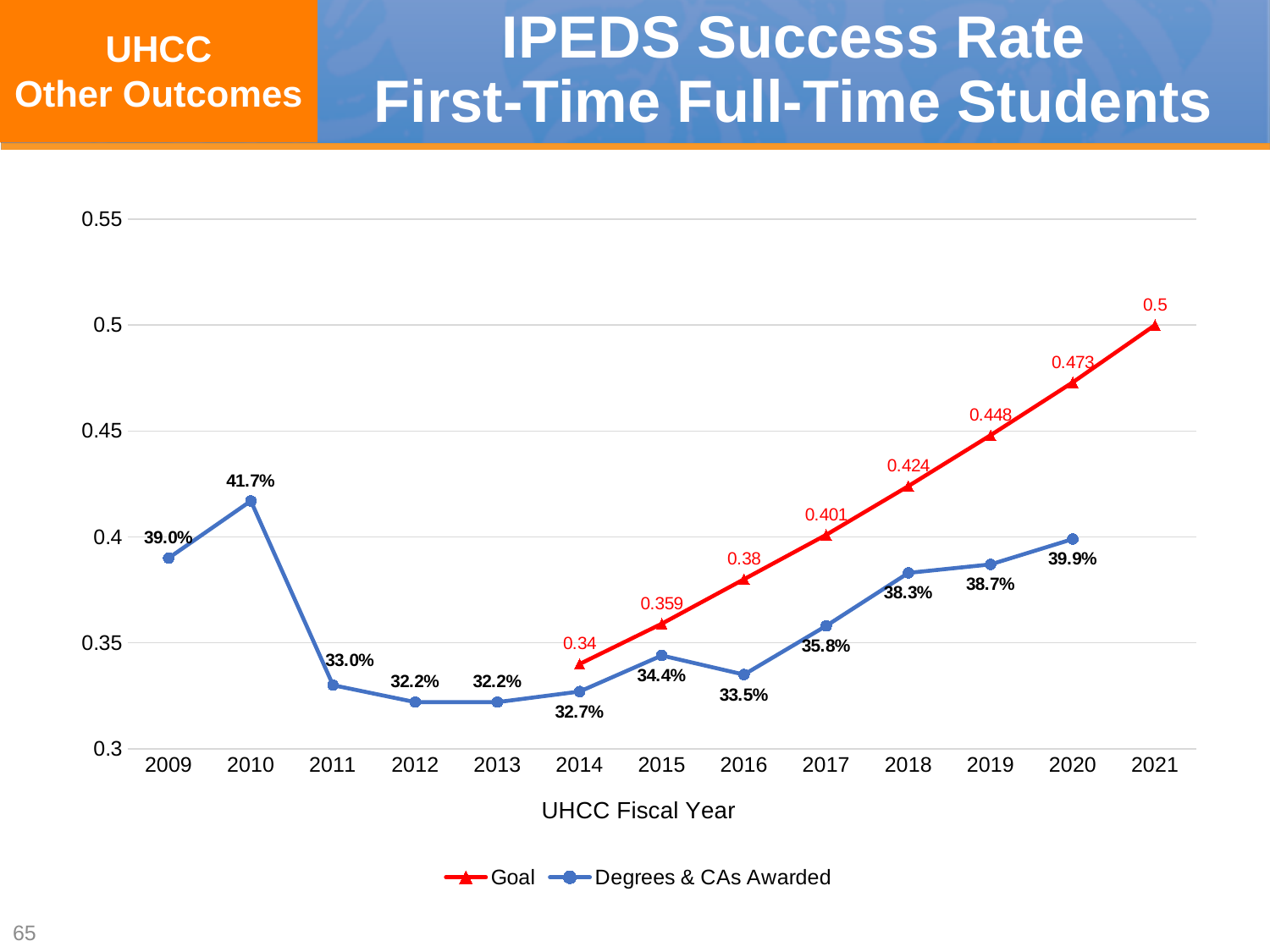
In which year is the Goal series lowest? 2014 What kind of chart is shown on the slide? line chart Is the Degrees & CAs Awarded value for 2016 greater or less than 0.35? less How many fiscal years are shown on the x axis? 13 In 2017, which series has the larger value, Goal or Degrees & CAs Awarded? Goal What is the Degrees & CAs Awarded value for 2010? 41.7% How many series does the legend list? 2 What is the difference between the Degrees & CAs Awarded values for 2020 and 2019? 1.2 percentage points In which year is the Degrees & CAs Awarded series highest? 2010 What is the Goal value for 2018? 0.424 Does the Goal series rise or fall from 2014 to 2021? rise What is the title of the x axis? UHCC Fiscal Year